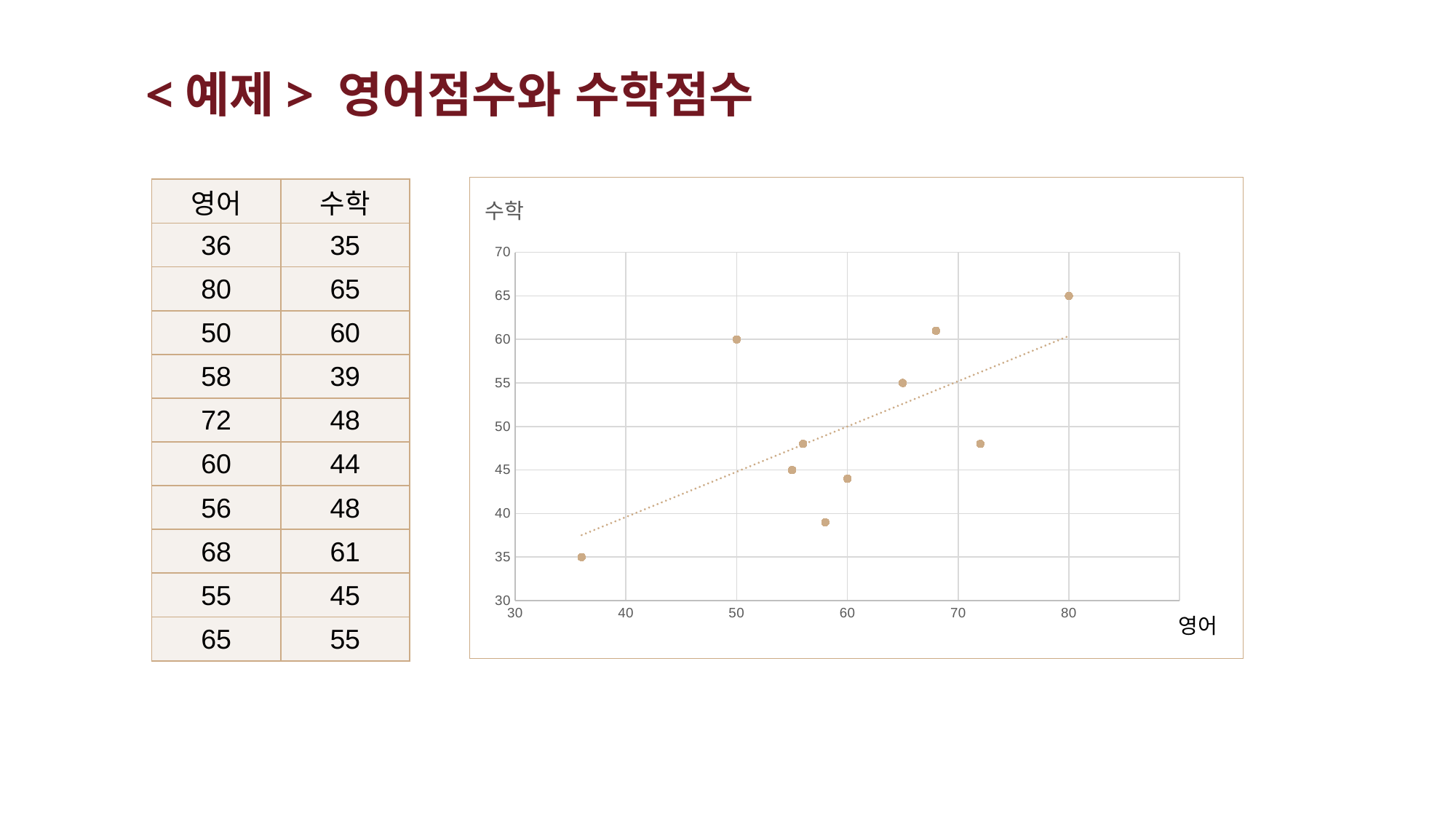
What is the 수학 score for the point with an 영어 score of 58? 39 What kind of chart is shown on the slide? scatter chart What is the label of the vertical axis of the chart? 수학 What is the lowest 수학 score plotted in the chart? 35 What is the difference between the 수학 scores at 영어 80 and 영어 36? 30 How many data points are plotted in the scatter chart? 10 What is the 수학 score for the point with an 영어 score of 50? 60 Which point has the higher 수학 score: the one at 영어 68 or the one at 영어 72? 영어 68 Is the 수학 score for the point at 영어 60 greater or less than 50? less Do the 수학 scores generally rise or fall as the 영어 score increases along the x axis? rise What is the highest 수학 score plotted in the chart? 65 What is the label of the horizontal axis of the chart? 영어